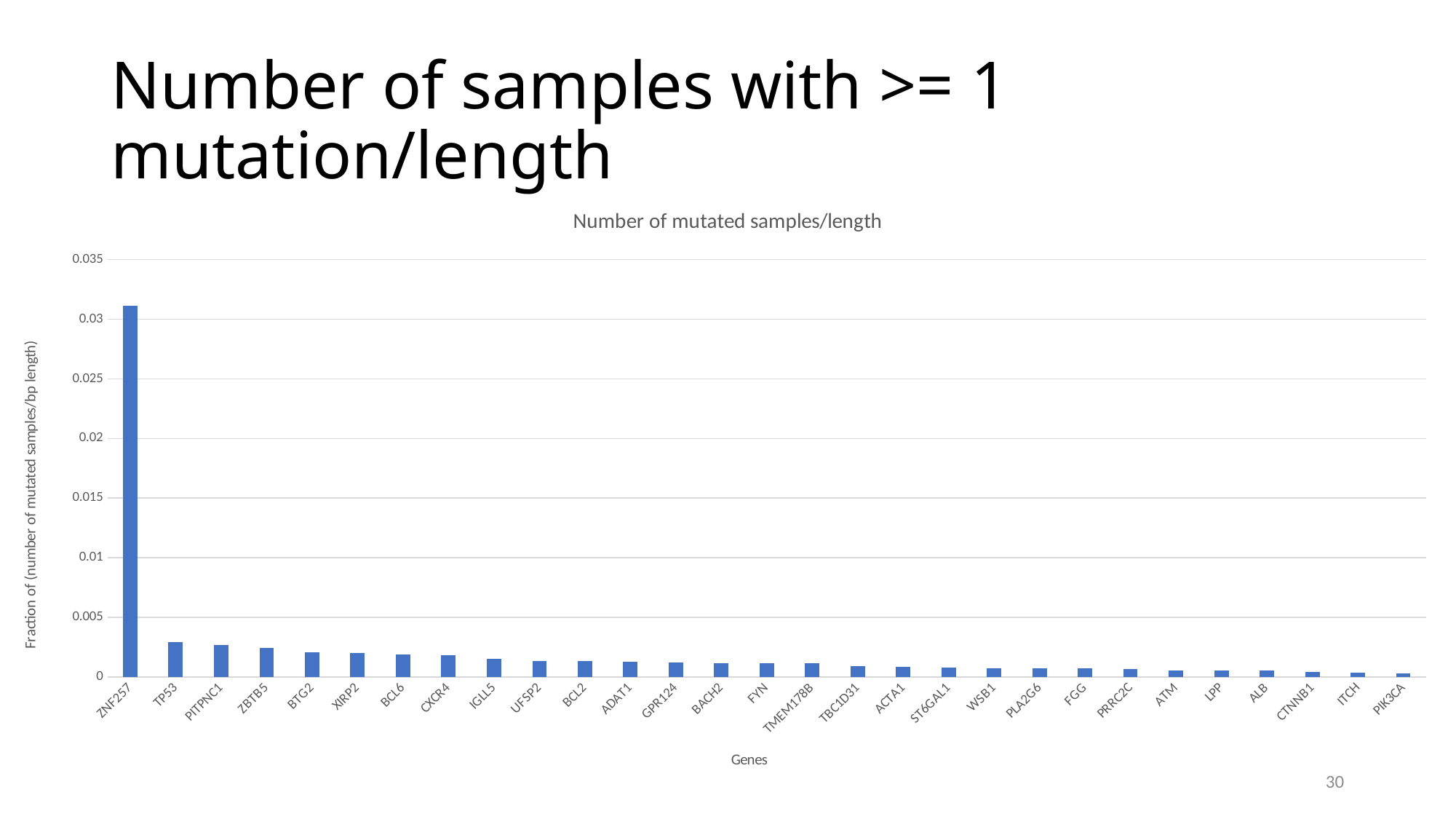
What kind of chart is shown on the slide? bar chart Do the values rise or fall moving from left to right along the x axis? fall What is the title of the chart? Number of mutated samples/length Which gene has the lowest value in the chart? PIK3CA How many genes are plotted on the x axis? 29 Which has the larger value, ZNF257 or TP53? ZNF257 Which gene has the highest value in the chart? ZNF257 Which has the larger value, TP53 or PIK3CA? TP53 Is the value for BCL6 greater or less than 0.005? less What is the label of the x axis? Genes Is the value for ZNF257 greater or less than 0.025? greater Is the value for TP53 greater or less than 0.005? less